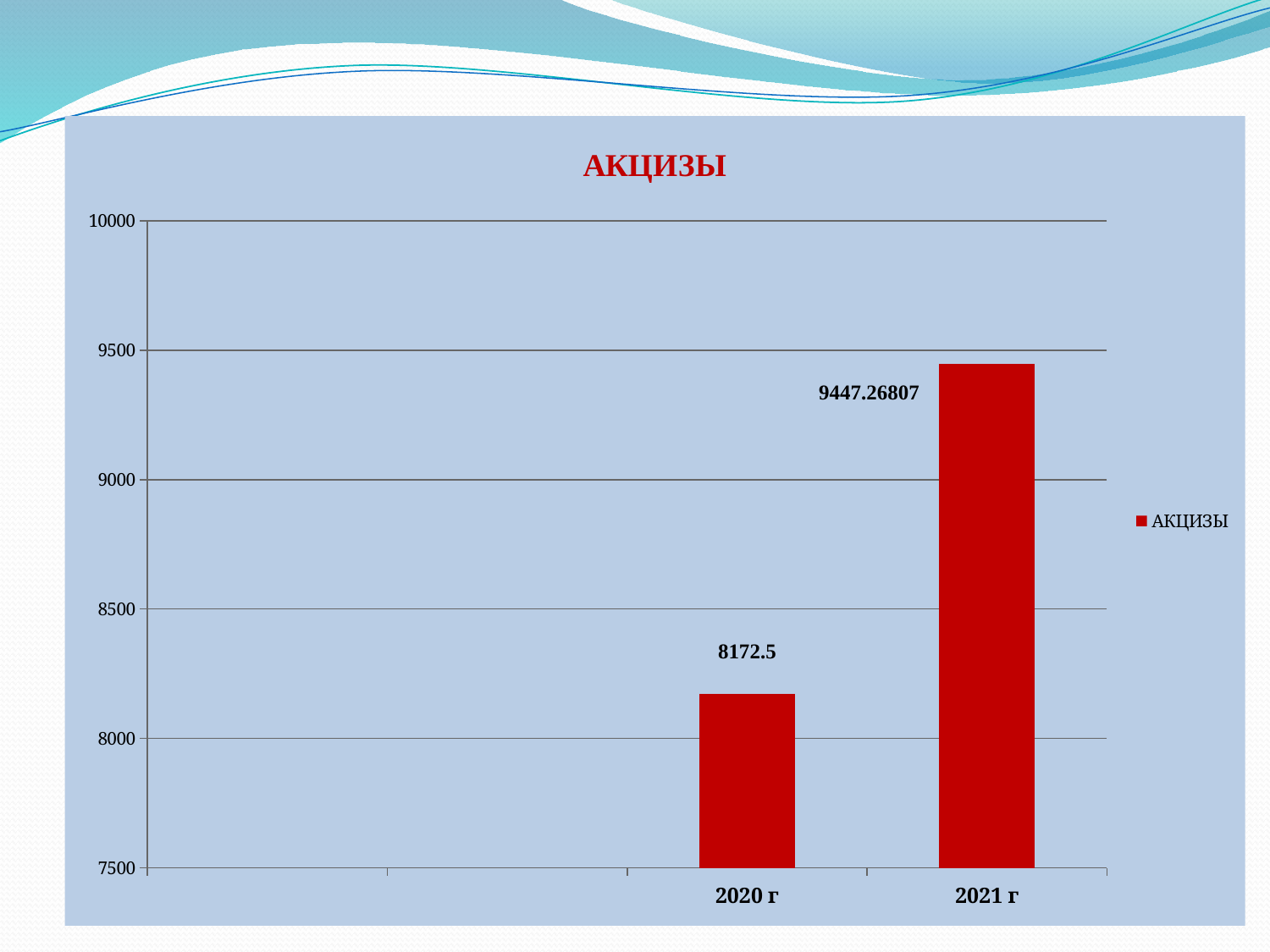
What is the title of the chart? АКЦИЗЫ What is the value for 2021 г? 9447.26807 Which is larger, the value for 2020 г or the value for 2021 г? 2021 г Which year has the highest value? 2021 г What is the difference between the values for 2021 г and 2020 г? 1274.76807 What is the value for 2020 г? 8172.5 Is the value for 2021 г greater or less than 9000? greater What kind of chart is shown? bar chart Is the value for 2020 г greater or less than 8500? less How many categories are shown on the x axis? 2 How many series does the legend list? 1 Which year has the lowest value? 2020 г